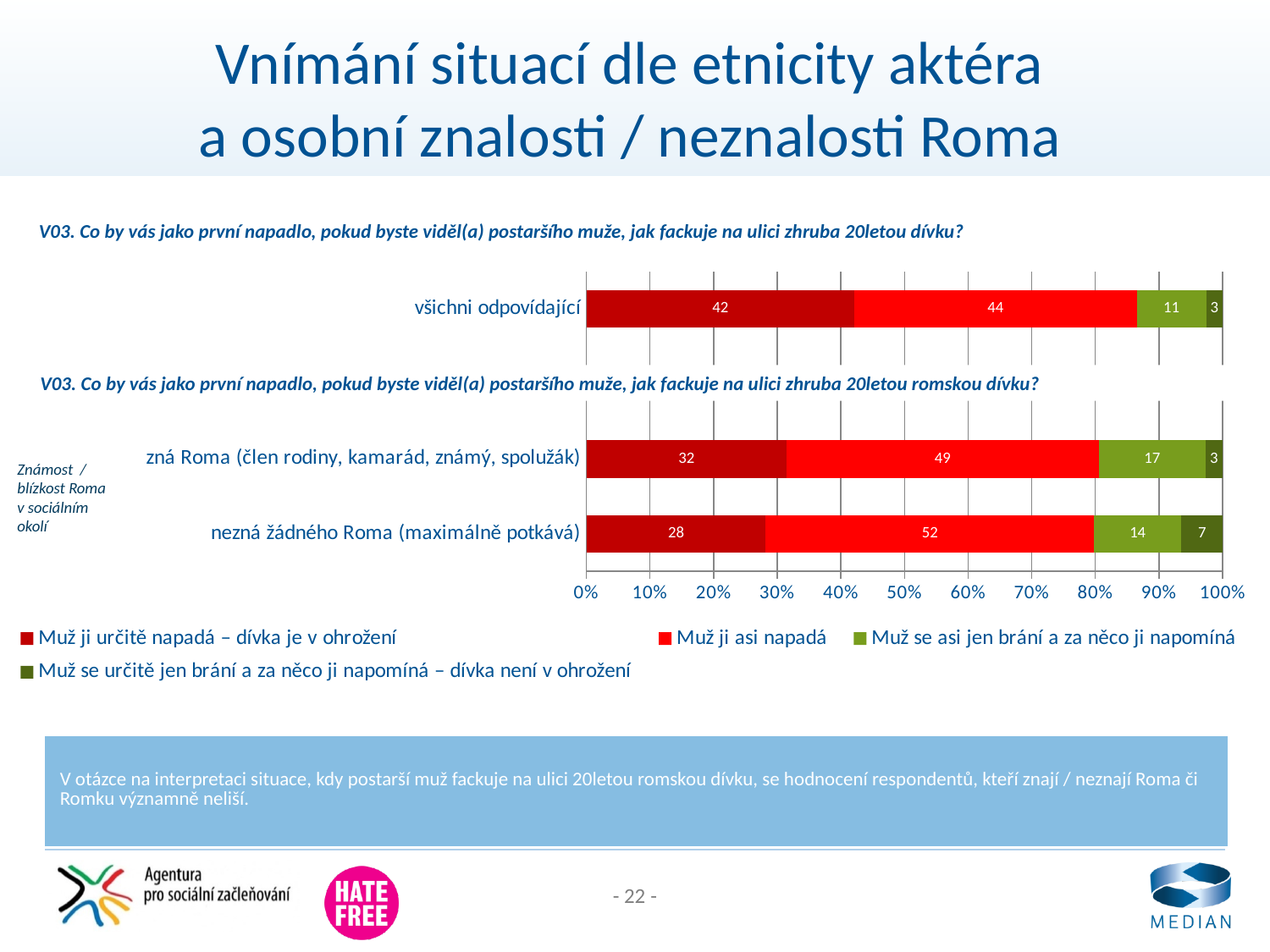
In the top chart, which series has the smallest value for 'všichni odpovídající'? Muž se určitě jen brání a za něco ji napomíná – dívka není v ohrožení What type of chart is used on this slide? Stacked bar chart In the top chart (všichni odpovídající), what is the value for 'Muž ji určitě napadá – dívka je v ohrožení'? 42 How many series does the legend list? 4 In the bottom chart, what is the value of 'Muž se asi jen brání a za něco ji napomíná' for 'zná Roma (člen rodiny, kamarád, známý, spolužák)'? 17 In the bottom chart, what is the difference between the 'Muž ji asi napadá' values for 'nezná žádného Roma' and 'zná Roma'? 3 In the bottom chart, which category has the higher value for 'Muž ji určitě napadá – dívka je v ohrožení': 'zná Roma' or 'nezná žádného Roma'? zná Roma (člen rodiny, kamarád, známý, spolužák) In the bottom chart, which series has the largest value for 'nezná žádného Roma (maximálně potkává)'? Muž ji asi napadá In the bottom chart, what is the difference between the 'Muž se určitě jen brání' values for 'nezná žádného Roma' and 'zná Roma'? 4 In the top chart (všichni odpovídající), what is the value for 'Muž ji asi napadá'? 44 How many categories (bars) does the bottom chart show? 2 In the bottom chart, what is the value of 'Muž ji asi napadá' for 'nezná žádného Roma (maximálně potkává)'? 52